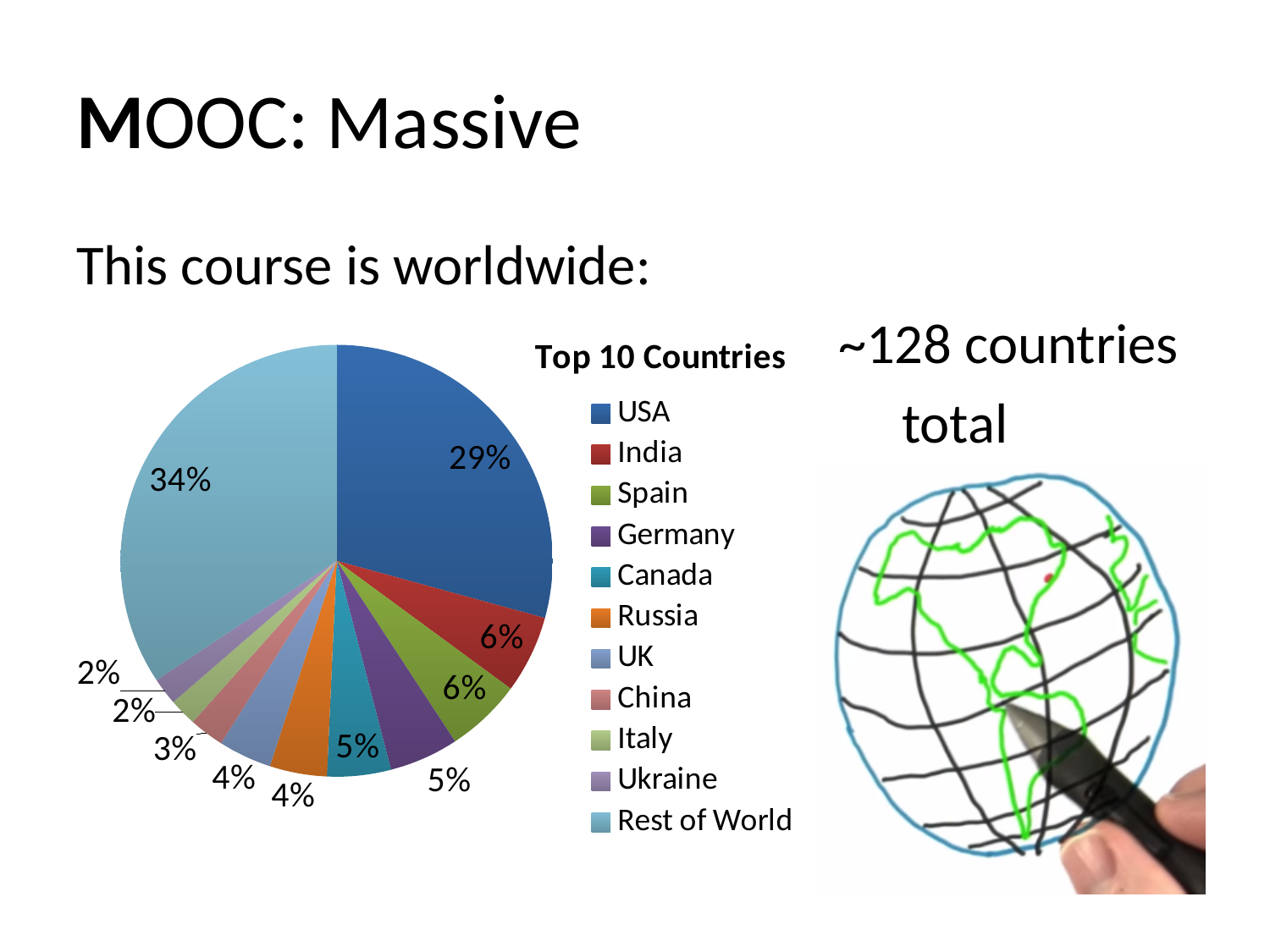
What percentage is shown for China? 3% How many entries does the legend list? 11 What share of the pie does the USA slice represent? 29% What percentage is shown for Rest of World? 34% What is the difference in percentage points between the USA slice and the India slice? 23% Which legend entry has the largest slice of the pie? Rest of World What is the title of the chart? Top 10 Countries What percentage is shown for Canada? 5% Which is larger, the USA slice or the Rest of World slice? Rest of World What percentage is shown for India? 6% What kind of chart is shown on the slide? Pie chart Which is larger, the India slice or the Russia slice? India